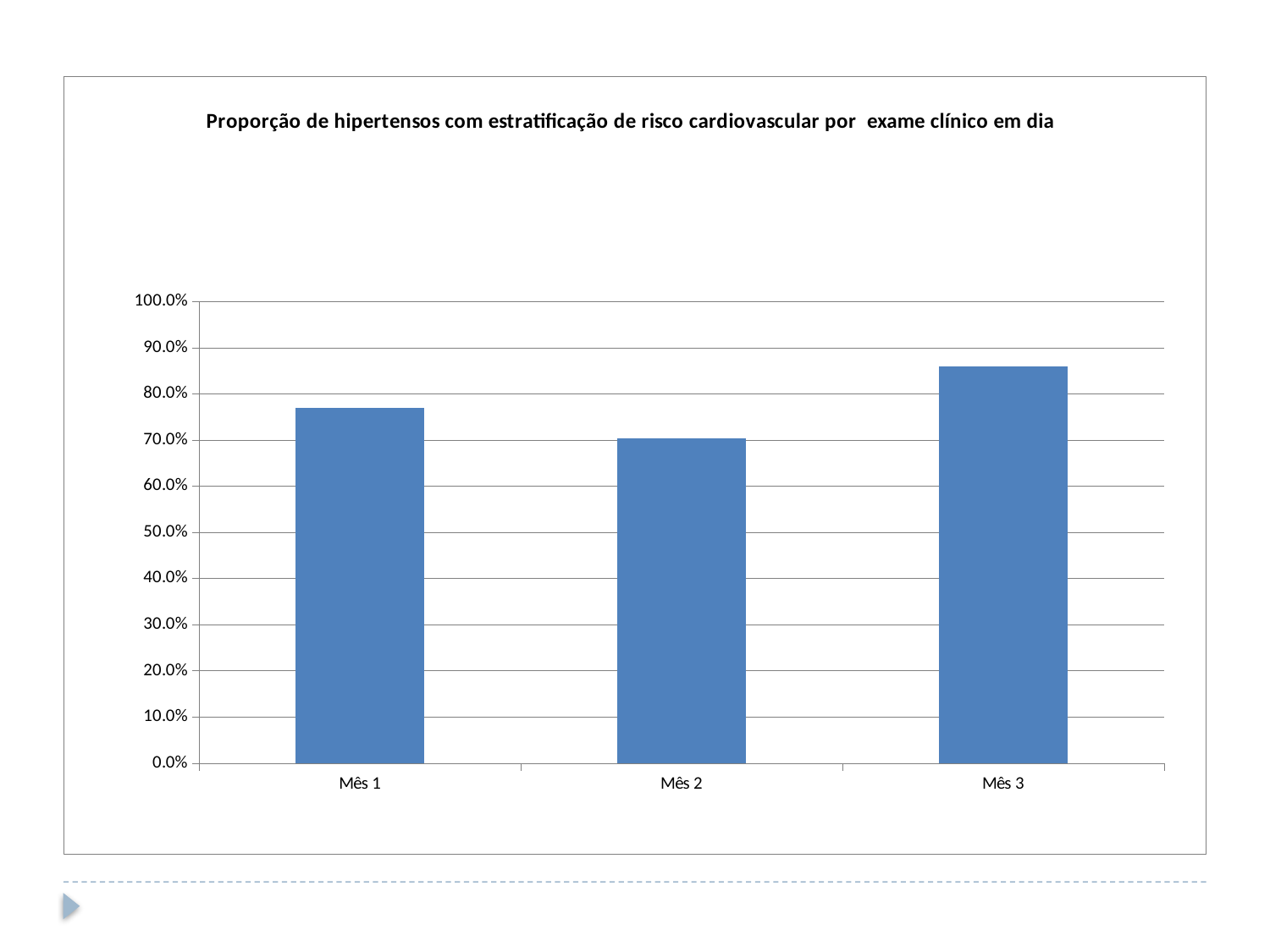
Which is larger, the value for Mês 3 or the value for Mês 1? Mês 3 How many categories (months) are plotted on the x axis? 3 Which month has the highest value? Mês 3 Does the value rise or fall from Mês 2 to Mês 3? rise Is the value for Mês 1 greater or less than 70.0%? greater Which is larger, the value for Mês 1 or the value for Mês 2? Mês 1 Is the value for Mês 3 greater or less than 80.0%? greater Is the value for Mês 1 greater or less than 80.0%? less What is the title of the chart? Proporção de hipertensos com estratificação de risco cardiovascular por exame clínico em dia What kind of chart is shown on the slide? bar chart Which month has the lowest value? Mês 2